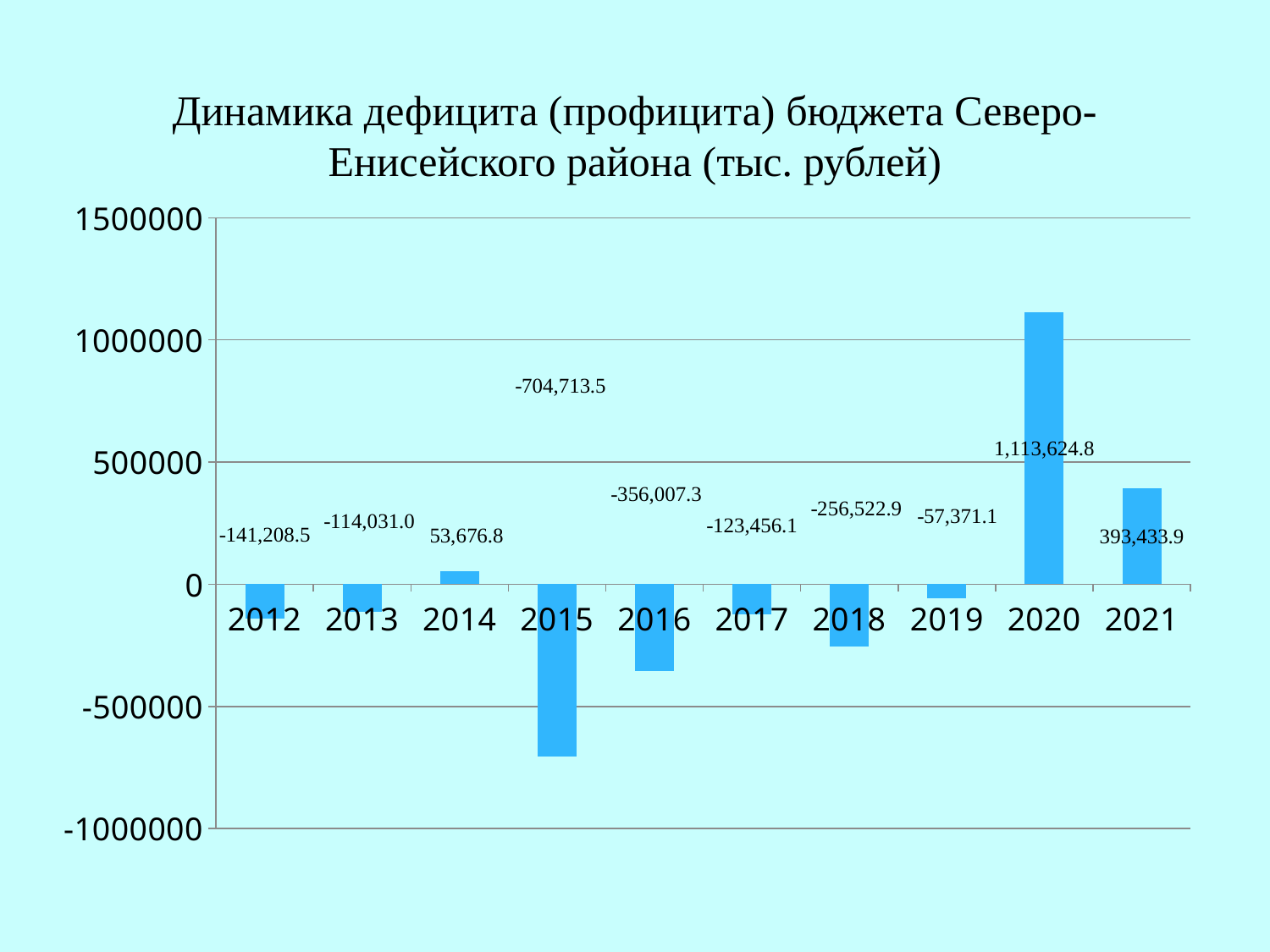
What kind of chart is shown on the slide? bar chart What is the value for 2019? -57,371.1 How many years are shown on the x axis? 10 In what units are the values given according to the chart title? тыс. рублей Which is larger, the value for 2016 or the value for 2018? 2018 What is the difference between the values for 2020 and 2021? 720,190.9 Which year has the highest value? 2020 Which year has the lowest value? 2015 What is the value for 2020? 1,113,624.8 Is the value for 2015 greater or less than -500000? less What is the value for 2015? -704,713.5 What is the value for 2014? 53,676.8